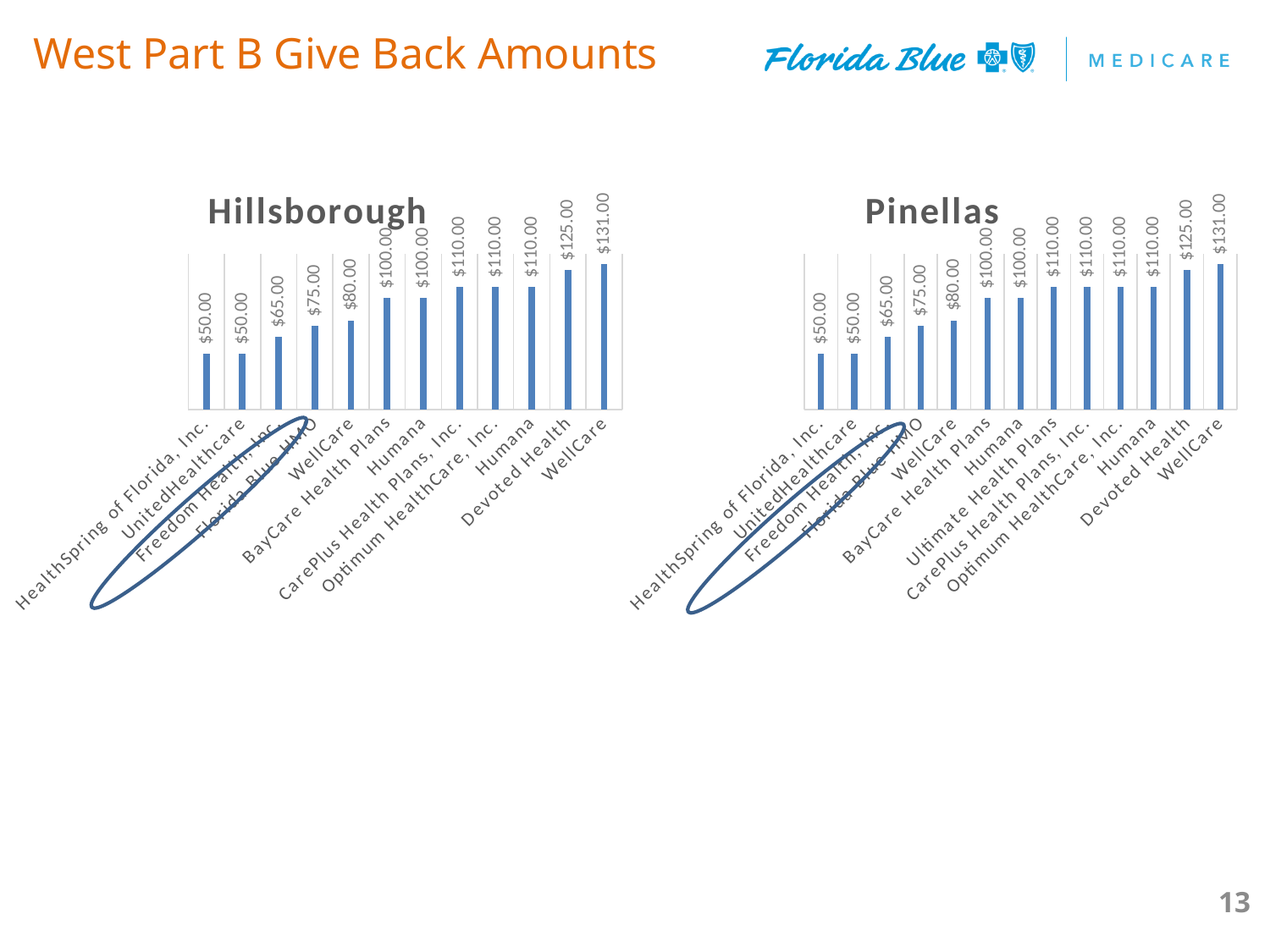
How many bars are in the Pinellas chart? 13 In the Hillsborough chart, do the values generally rise or fall from left to right? Rise In the Pinellas chart, what is the value for BayCare Health Plans? $100.00 In the Hillsborough chart, what is the highest value shown? $131.00 In the Pinellas chart, what is the give back amount for Ultimate Health Plans? $110.00 How many bars are in the Hillsborough chart? 12 In the Hillsborough chart, what is the difference between Devoted Health and Freedom Health, Inc.? $60.00 In the Hillsborough chart, what is the give back amount for Devoted Health? $125.00 In the Pinellas chart, what is the lowest value shown? $50.00 In the Hillsborough chart, what is the value for Freedom Health, Inc.? $65.00 In the Pinellas chart, which is larger: the value for Devoted Health or the value for BayCare Health Plans? Devoted Health What type of chart is the Pinellas chart? Bar chart